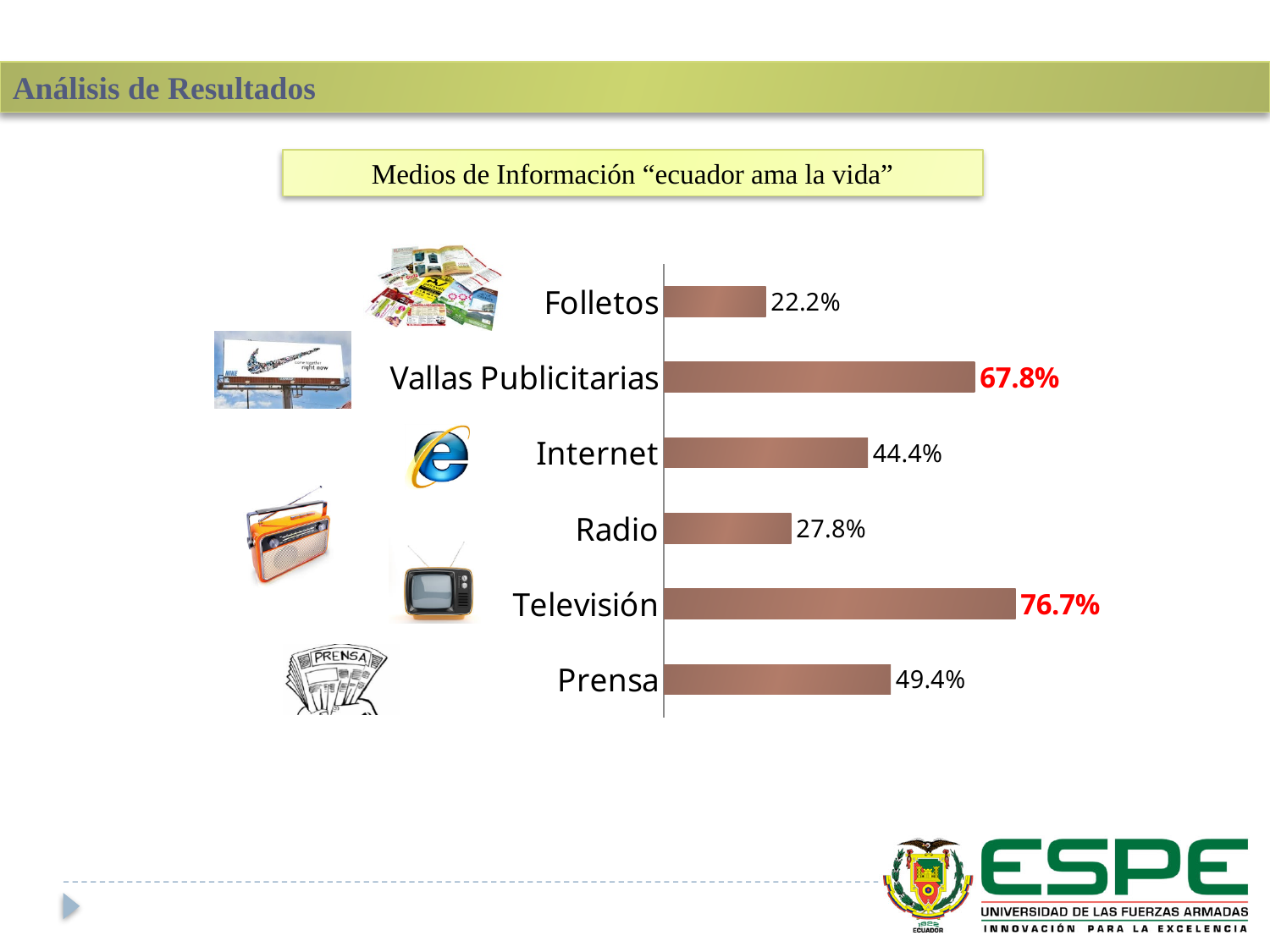
What is the difference between the values for Televisión and Vallas Publicitarias? 8.9% Which category has the lowest value? Folletos What kind of chart is shown on the slide? Bar chart What is the difference between the values for Internet and Radio? 16.6% What is the value for Televisión? 76.7% What is the value for Vallas Publicitarias? 67.8% What is the value for Folletos? 22.2% What is the value for Prensa? 49.4% Which category has the highest value? Televisión How many categories are shown in the chart? 6 Which is larger, the value for Prensa or the value for Internet? Prensa Which two data labels are highlighted in red? 67.8% and 76.7%